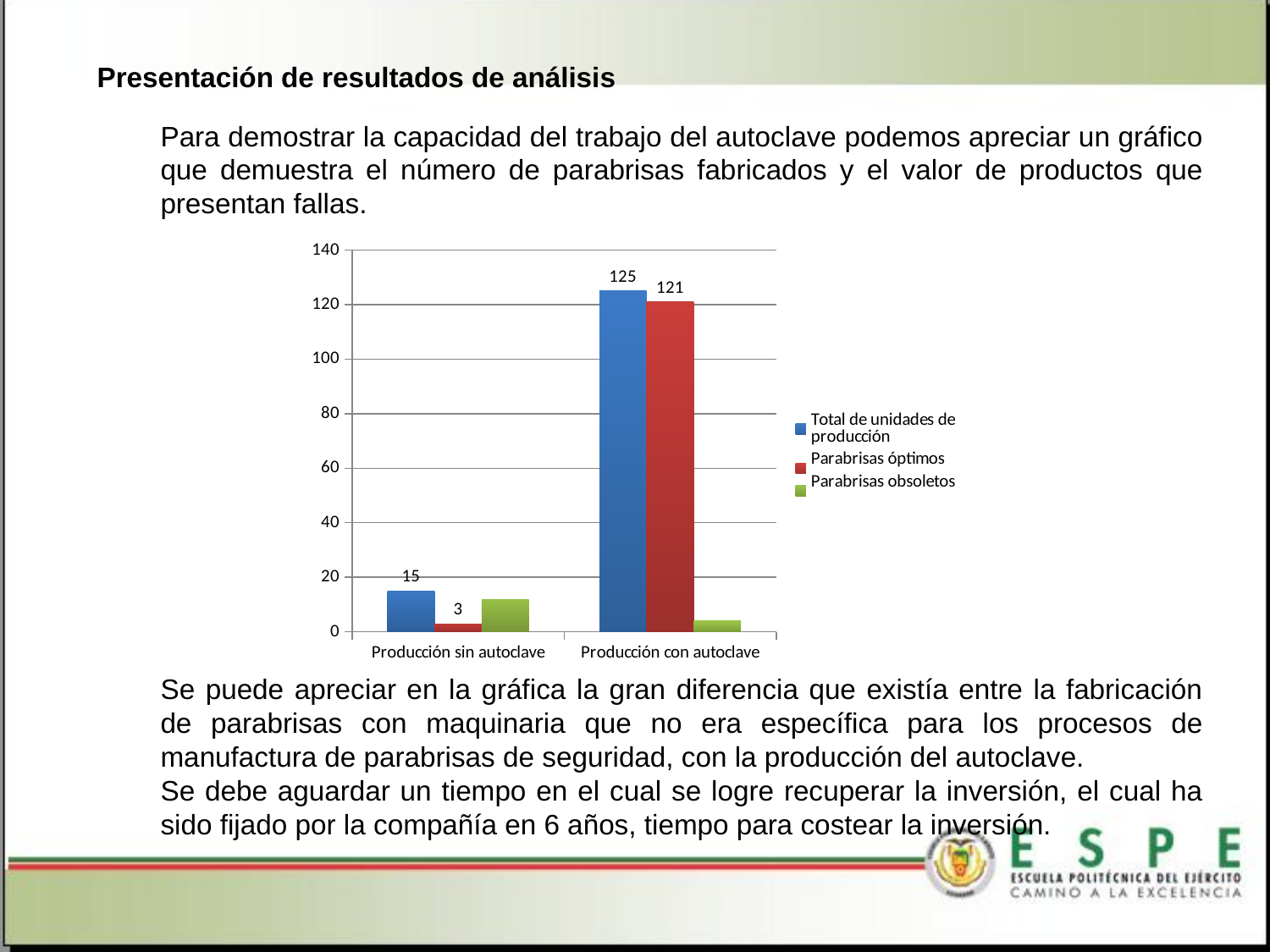
Which category has the higher Total de unidades de producción, Producción sin autoclave or Producción con autoclave? Producción con autoclave What is the value of Parabrisas óptimos for Producción sin autoclave? 3 How many series does the chart's legend list? 3 How many categories are shown on the x axis of the chart? 2 What is the value of Total de unidades de producción for Producción sin autoclave? 15 What is the value of Total de unidades de producción for Producción con autoclave? 125 What is the value of Parabrisas óptimos for Producción con autoclave? 121 What is the difference between Total de unidades de producción and Parabrisas óptimos for Producción con autoclave? 4 Is the value of Parabrisas obsoletos for Producción con autoclave greater or less than 20? less Is the value of Parabrisas obsoletos for Producción sin autoclave greater or less than 20? less What kind of chart is shown on the slide? Bar chart What is the difference between Total de unidades de producción and Parabrisas óptimos for Producción sin autoclave? 12